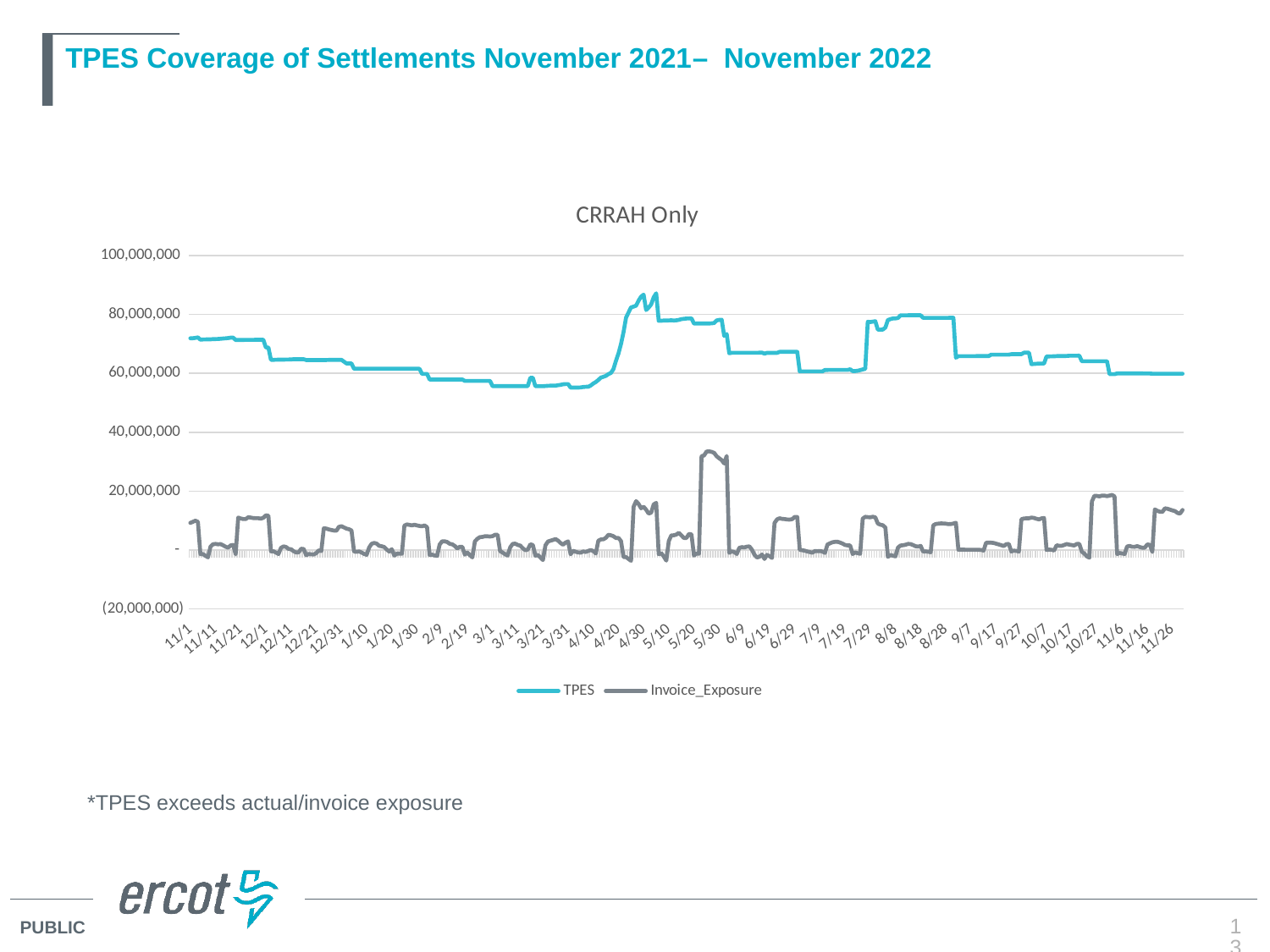
Is the Invoice_Exposure value on 11/26 greater or less than 20,000,000? less What kind of chart is shown on the slide? line chart Is the peak TPES value around 4/30 greater or less than 80,000,000? greater Which series has the higher values across the whole period, TPES or Invoice_Exposure? TPES Which series is drawn in light blue according to the legend? TPES What is the title of the chart? CRRAH Only Is the TPES value on 11/1 greater or less than 80,000,000? less How many series does the legend list? 2 Which series is higher on 5/30, TPES or Invoice_Exposure? TPES